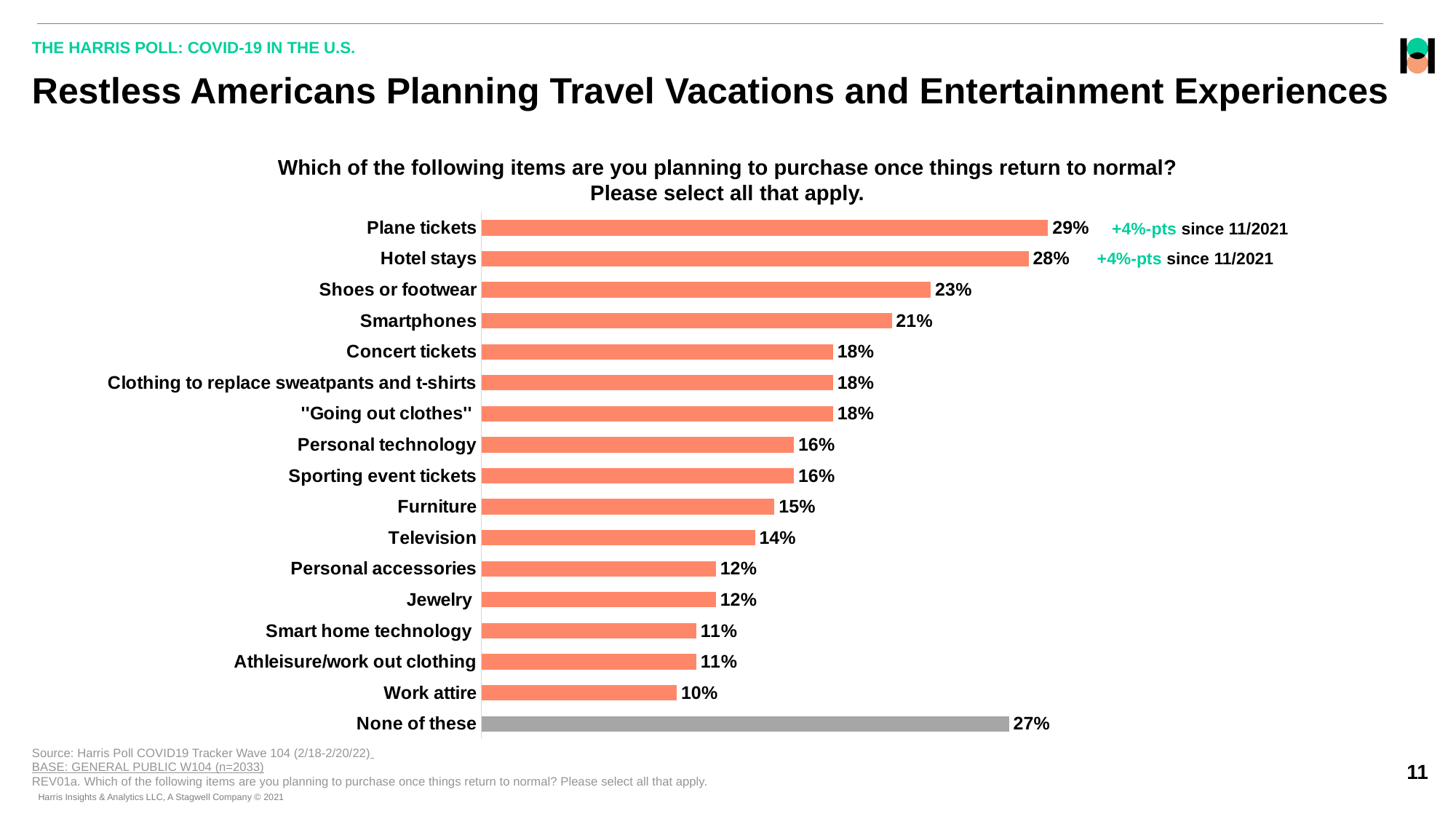
Which bar is shown in a different colour (grey) from the others? None of these By how many percentage points has the value for Hotel stays changed since 11/2021? +4%-pts What type of chart is shown on the slide? Bar chart Which item has the highest percentage of respondents planning to purchase it? Plane tickets Which item has the lowest percentage among the purchase items (excluding None of these)? Work attire What is the difference in percentage points between Plane tickets and Shoes or footwear? 6 What percentage is shown for Work attire? 10% How many categories are shown in the chart? 17 What is the value for None of these? 27% What percentage of respondents are planning to purchase plane tickets? 29% Which is larger, the value for Smartphones or the value for Television? Smartphones What is the value shown for Hotel stays? 28%